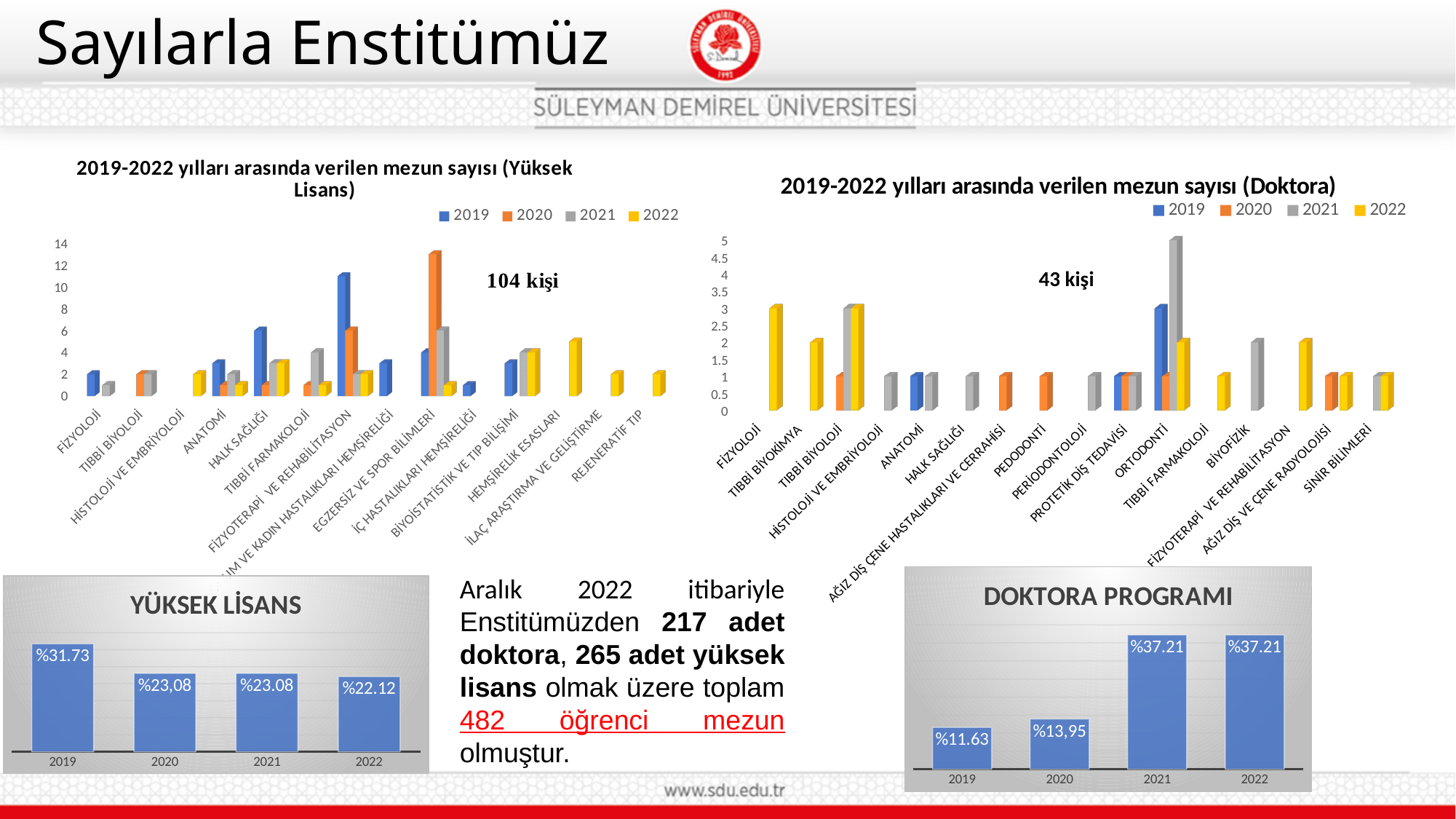
How many bars are shown in the bottom-left chart titled YÜKSEK LİSANS? 4 In the top-right chart (Doktora mezun sayısı), is the 2021 value for ORTODONTİ greater or less than 4? greater In the bottom-right chart titled DOKTORA PROGRAMI, which is larger: the value for 2020 or the value for 2021? 2021 What kind of chart is the top-right chart titled 2019-2022 yılları arasında verilen mezun sayısı (Doktora)? bar chart In the bottom-right chart titled DOKTORA PROGRAMI, do the values generally rise or fall from 2019 to 2022? rise In the bottom-right chart titled DOKTORA PROGRAMI, what is the value for 2020? %13,95 In the bottom-right chart titled DOKTORA PROGRAMI, which year has the lowest value? 2019 In the bottom-left chart titled YÜKSEK LİSANS, what is the value for 2019? %31.73 In the bottom-left chart titled YÜKSEK LİSANS, what is the difference between the 2019 value and the 2022 value? %9.61 In the bottom-left chart titled YÜKSEK LİSANS, which year has the highest value? 2019 How many series does the legend list in the top-left chart (Yüksek Lisans mezun sayısı)? 4 In the top-left chart (Yüksek Lisans mezun sayısı), is the 2020 value for EGZERSİZ VE SPOR BİLİMLERİ greater or less than 10? greater